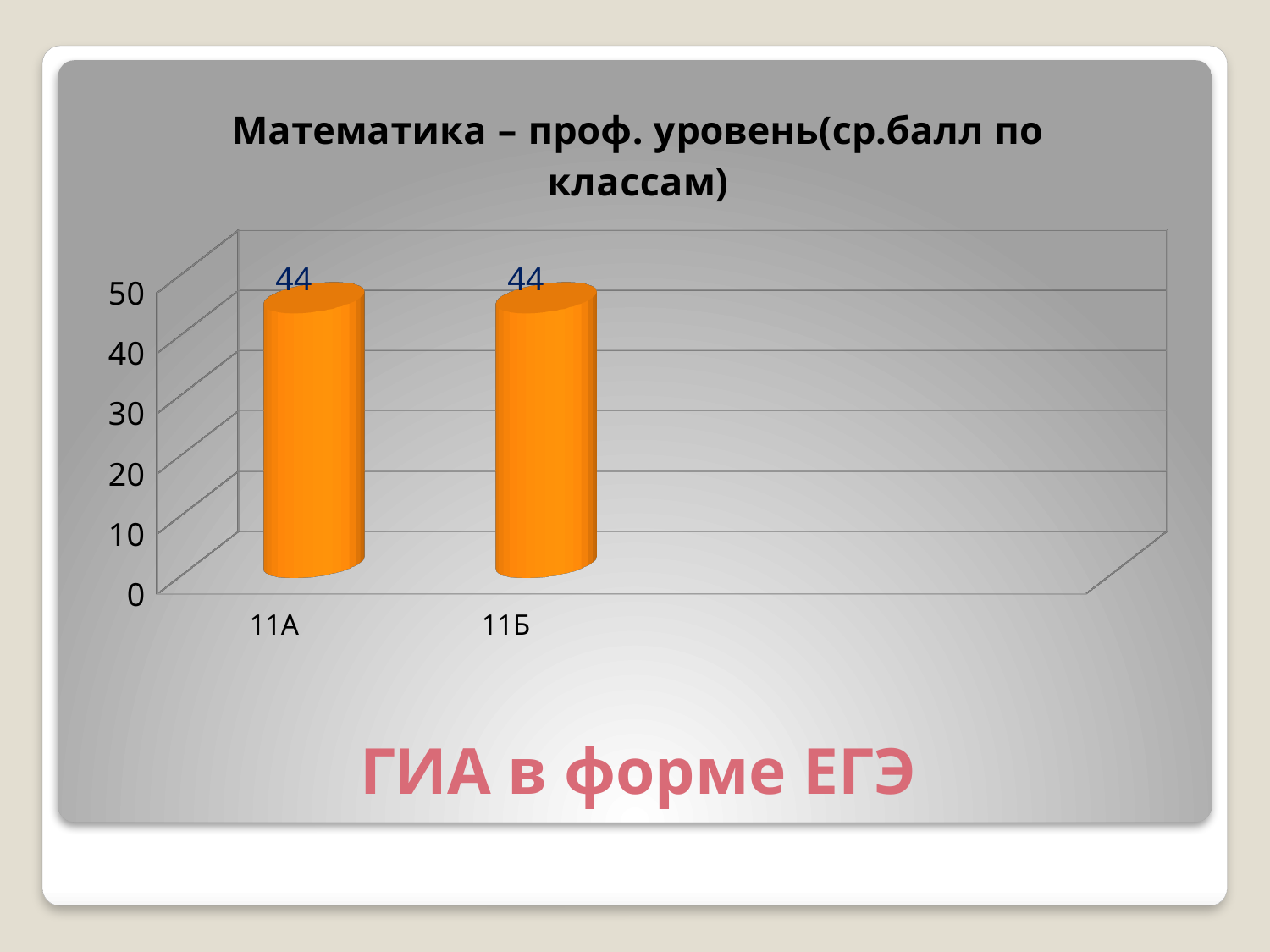
What is the value for 11А? 44 Is the value for 11Б greater or less than 50? less Is the value for 11А greater or less than 40? greater How many categories are shown on the x axis? 2 What is the difference between the values for 11А and 11Б? 0 What is the title of the chart? Математика – проф. уровень(ср.балл по классам) What kind of chart is shown on the slide? bar chart What colour are the bars in the chart? orange What is the value for 11Б? 44 Do the values rise, fall or stay the same from 11А to 11Б? stay the same What is the highest value shown on the vertical axis? 50